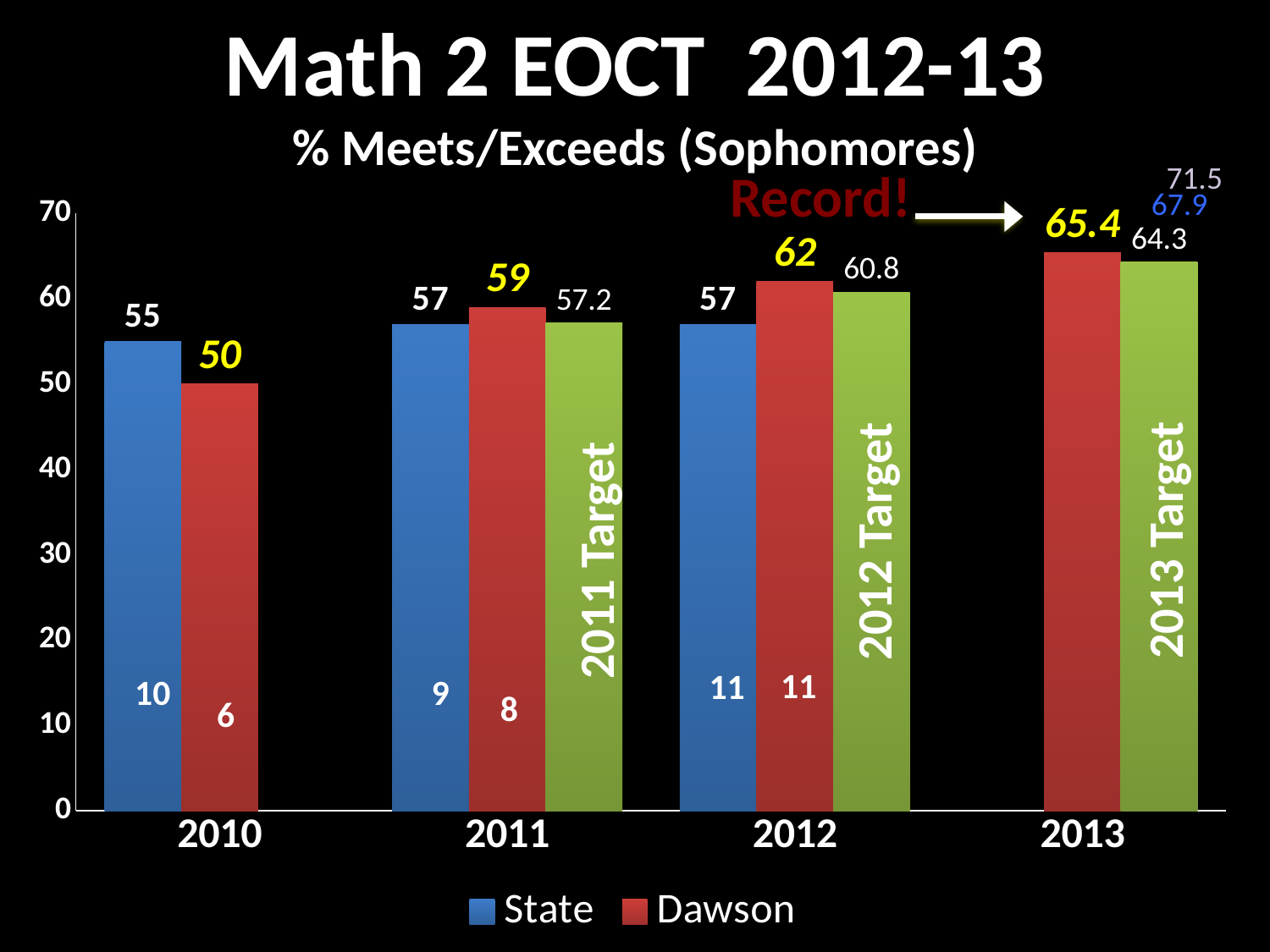
In which year is the Dawson value highest? 2013 What is the value of the 2011 Target bar? 57.2 How many series does the legend list? 2 What is the value of the 2013 Target bar? 64.3 In which year is the Dawson value lowest? 2010 How many years are shown on the x axis? 4 What is the Dawson value for 2012? 62 What is the State value for 2010? 55 What kind of chart is shown on the slide? bar chart What is the difference between the Dawson and State values in 2012? 5 Which is larger in 2011, the State value or the Dawson value? Dawson Do the Dawson values rise or fall from 2010 to 2013? rise